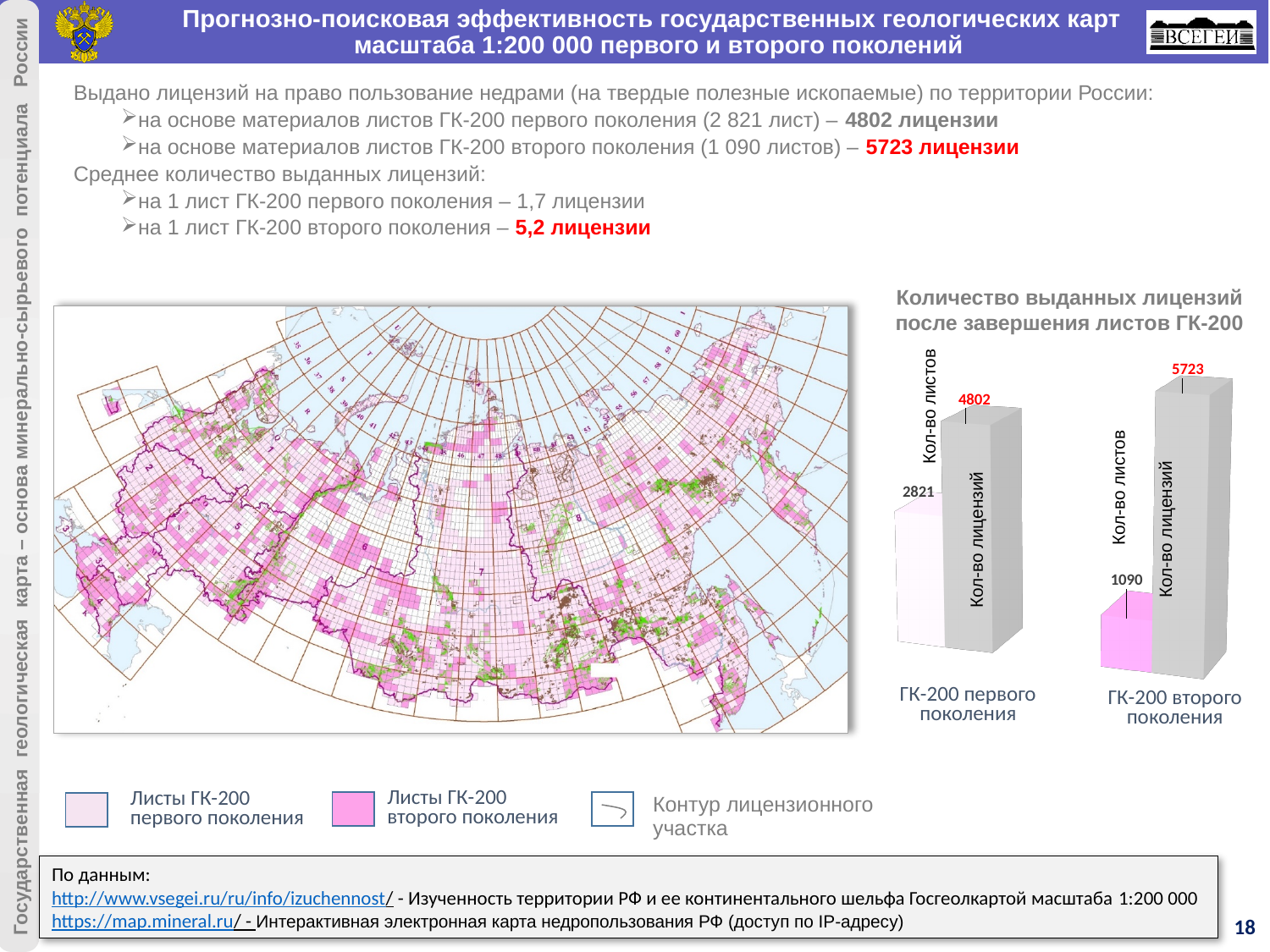
What kind of chart is used to show the number of licences issued? Bar chart Which generation has the lower number of sheets in the chart? ГК-200 второго поколения Which generation has the higher number of licences issued in the chart? ГК-200 второго поколения What is the difference between the number of licences for ГК-200 второго поколения and ГК-200 первого поколения? 921 What is the number of sheets (Кол-во листов) for ГК-200 первого поколения in the chart? 2821 Is the number of sheets larger for ГК-200 первого поколения or ГК-200 второго поколения? ГК-200 первого поколения What is the number of sheets (Кол-во листов) for ГК-200 второго поколения in the chart? 1090 What is the difference between the number of sheets for ГК-200 первого поколения and ГК-200 второго поколения? 1731 What is the number of licences (Кол-во лицензий) for ГК-200 второго поколения in the chart? 5723 What is the number of licences (Кол-во лицензий) for ГК-200 первого поколения in the chart? 4802 What is the title of the chart on the right of the slide? Количество выданных лицензий после завершения листов ГК-200 How many generation categories are shown on the x axis of the chart? 2